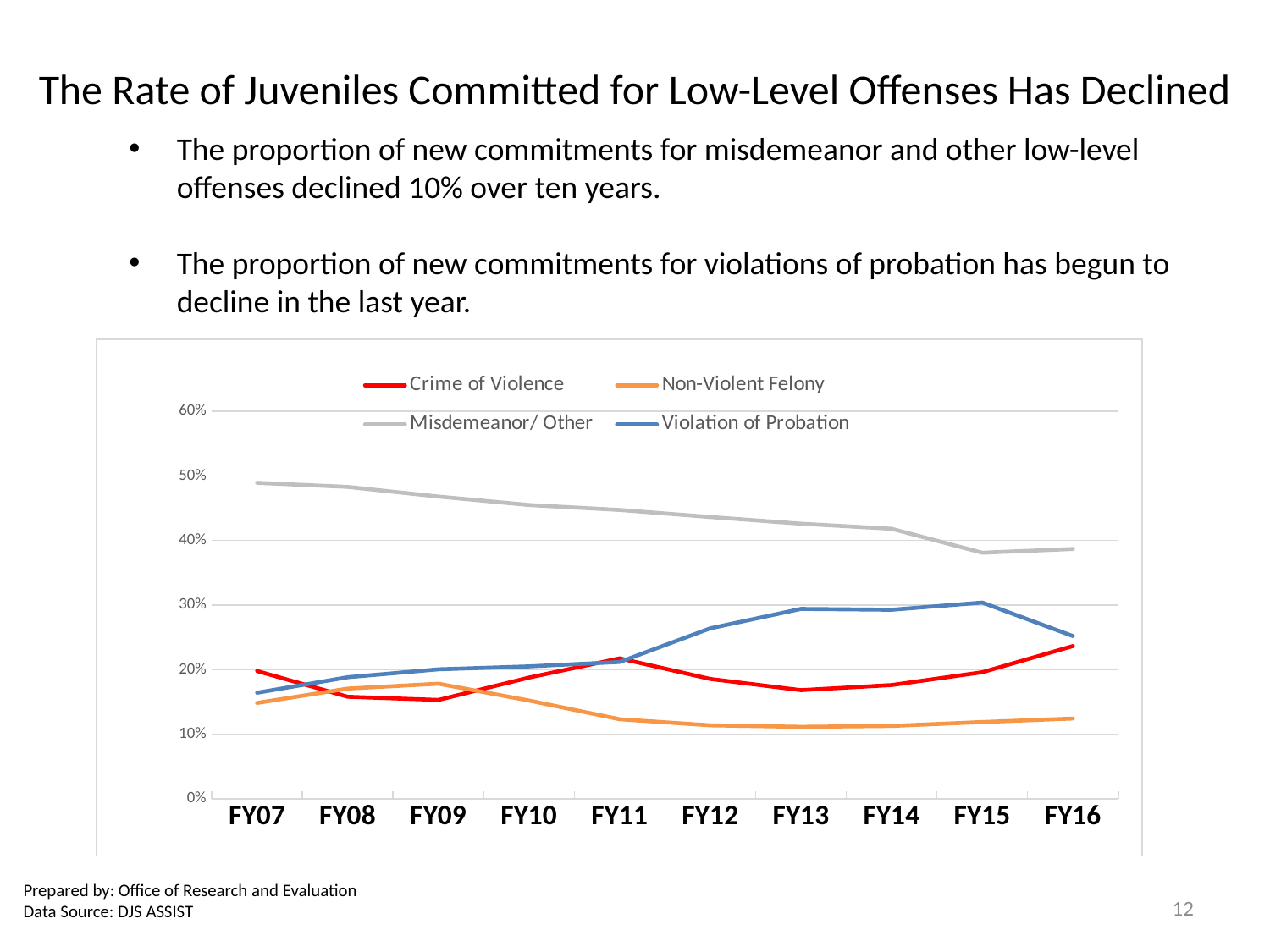
Is the value for Non-Violent Felony in FY13 greater or less than 20%? less Which series is drawn in red in the chart? Crime of Violence Which series has the lowest value in FY16? Non-Violent Felony Is the value for Misdemeanor/ Other in FY07 greater or less than 40%? greater How many series does the chart legend list? 4 What kind of chart is shown on the slide? line chart Which series has the highest value in FY07? Misdemeanor/ Other Does the Misdemeanor/ Other line rise or fall from FY07 to FY16? fall Is the value for Violation of Probation in FY15 greater or less than 20%? greater How many fiscal years are plotted along the x axis? 10 In FY13, which is larger: Violation of Probation or Crime of Violence? Violation of Probation